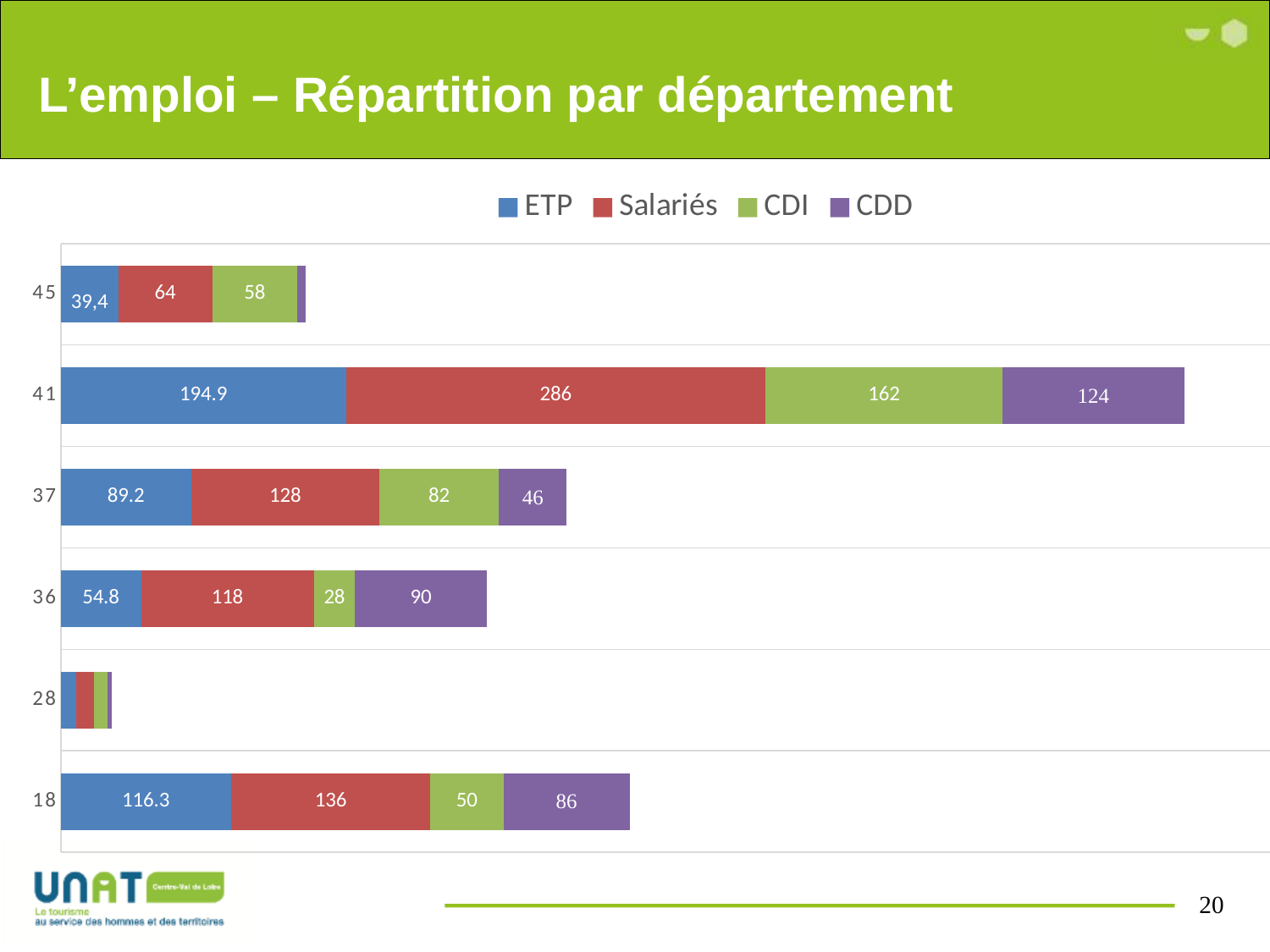
What is the total of the stacked bar for department 37? 345.2 What is the Salariés value for department 41? 286 How many series does the legend list? 4 Which colour represents the CDD series in the legend? Purple What is the CDD value for department 37? 46 What is the difference between the Salariés values for departments 41 and 37? 158 How many departments (categories) are shown on the chart? 6 What is the ETP value for department 18? 116.3 What type of chart is shown on the slide? Stacked bar chart Which is larger, the CDI value for department 36 or the CDI value for department 45? Department 45 Which department has the shortest total bar? 28 Which department has the highest Salariés value? 41